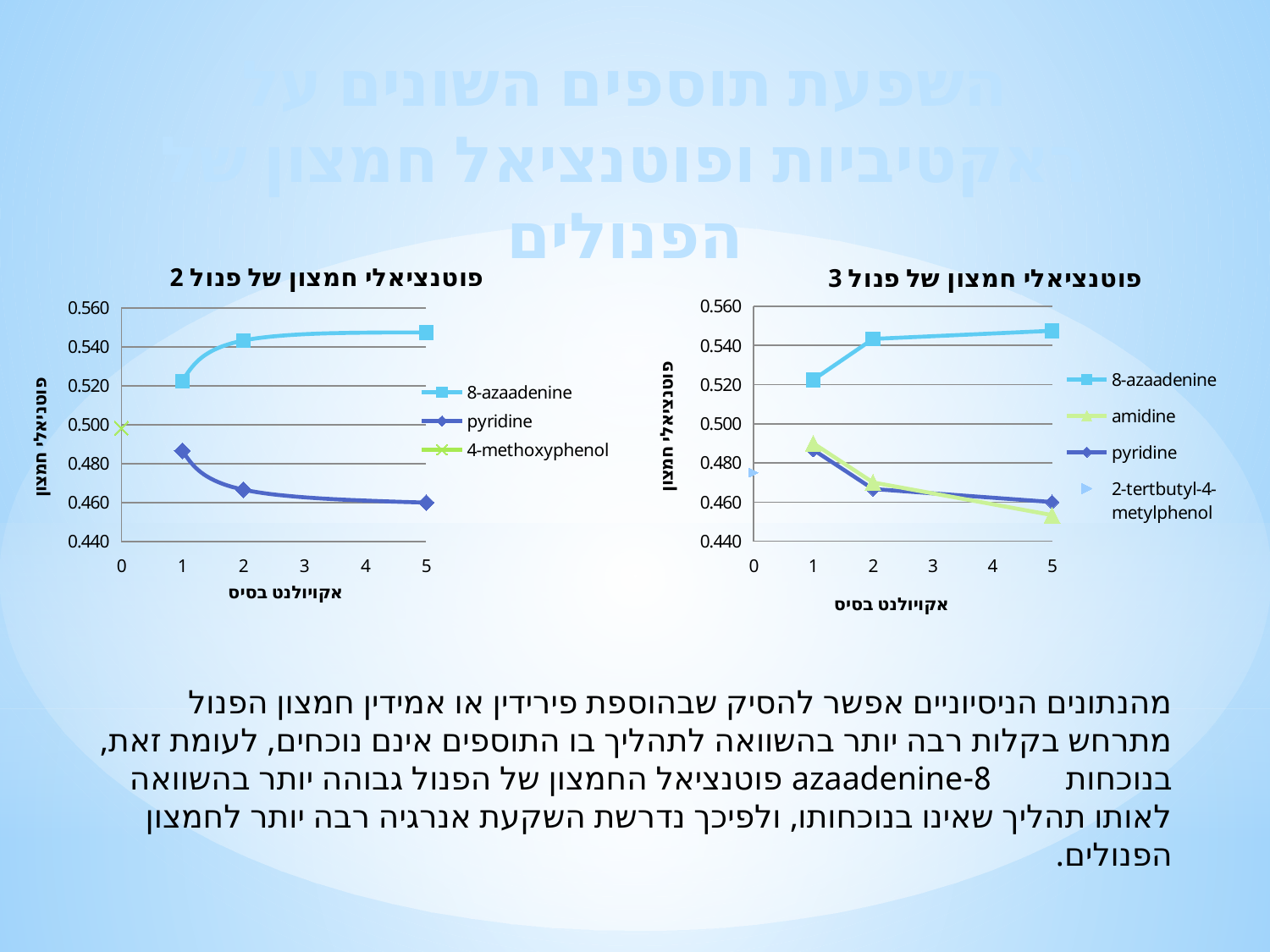
In the chart titled 'פוטנציאלי חמצון של פנול 2' (left), what kind of chart is shown? line chart In the chart titled 'פוטנציאלי חמצון של פנול 2' (left), is the value for 8-azaadenine at x = 5 greater or less than 0.540? greater In the chart titled 'פוטנציאלי חמצון של פנול 2' (left), is the value for pyridine at x = 5 greater or less than 0.480? less In the chart titled 'פוטנציאלי חמצון של פנול 3' (right), does the amidine series rise or fall as the x value increases? fall In the chart titled 'פוטנציאלי חמצון של פנול 3' (right), which series has the higher value at x = 1, 8-azaadenine or amidine? 8-azaadenine In the chart titled 'פוטנציאלי חמצון של פנול 2' (left), how many series does the legend list? 3 In the chart titled 'פוטנציאלי חמצון של פנול 2' (left), is the value for 4-methoxyphenol at x = 0 greater or less than 0.480? greater In the chart titled 'פוטנציאלי חמצון של פנול 2' (left), which series has the higher value at x = 2, 8-azaadenine or pyridine? 8-azaadenine In the chart titled 'פוטנציאלי חמצון של פנול 3' (right), how many series does the legend list? 4 In the chart titled 'פוטנציאלי חמצון של פנול 2' (left), does the pyridine series rise or fall as the x value increases? fall In the chart titled 'פוטנציאלי חמצון של פנול 2' (left), does the 8-azaadenine series rise or fall as the x value increases? rise